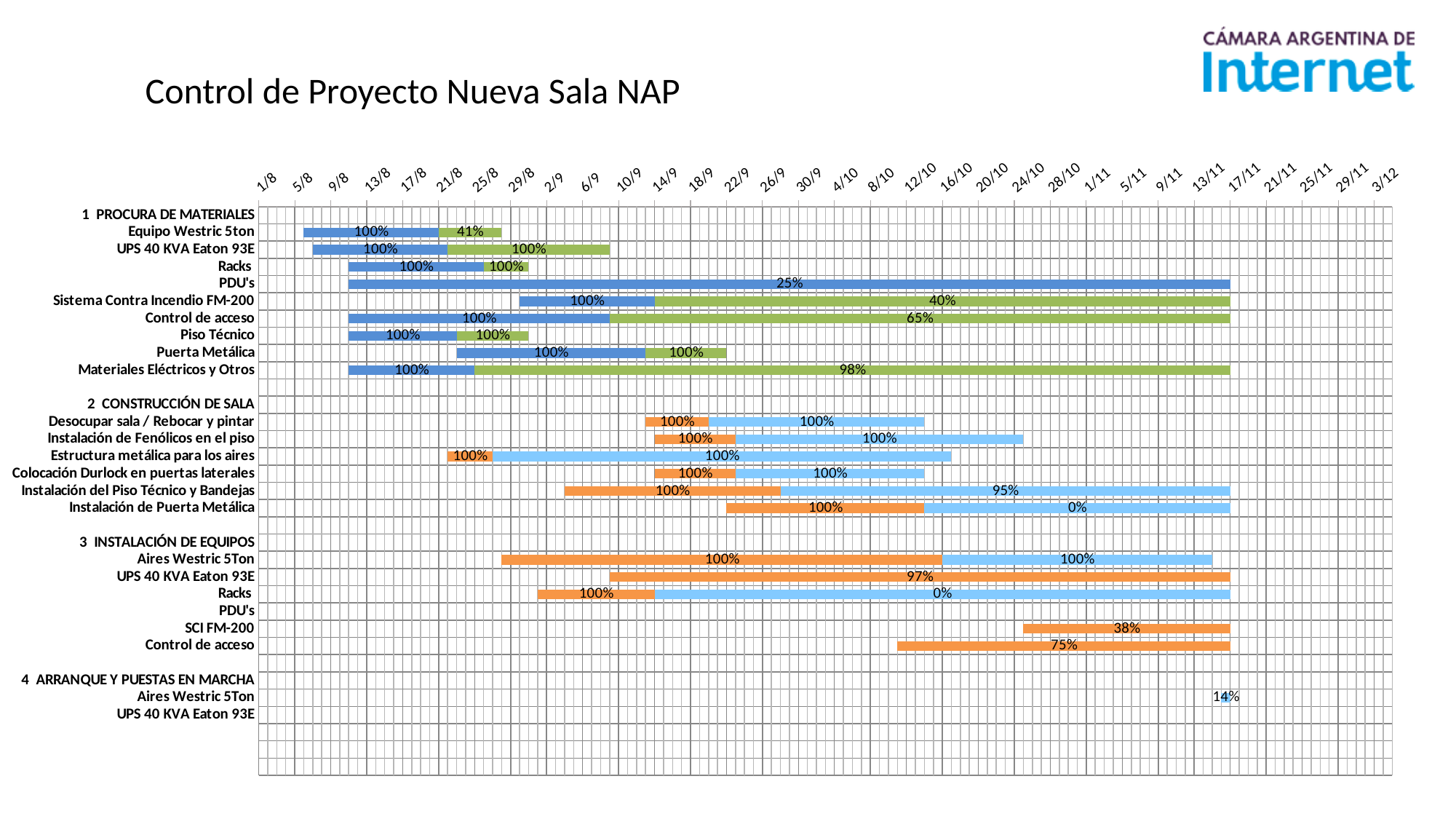
Which has a higher printed percentage in section 1: the green bar for Control de acceso or the green bar for Sistema Contra Incendio FM-200? Control de acceso What percentage is printed on the SCI FM-200 bar in section 3 Instalación de Equipos? 38% What is the title of the slide? Control de Proyecto Nueva Sala NAP What percentage is printed on the Control de acceso bar in section 3 Instalación de Equipos? 75% What percentage is shown on the green bar for Equipo Westric 5ton in section 1 Procura de Materiales? 41% What is the difference between the percentage on the Control de acceso bar (75%) and the SCI FM-200 bar (38%) in section 3 Instalación de Equipos? 37% What percentage is shown on the green bar for Sistema Contra Incendio FM-200? 40% What percentage is printed on the PDU's bar in section 1 Procura de Materiales? 25% What percentage is shown for Aires Westric 5Ton in section 4 Arranque y Puestas en Marcha? 14% What percentage is shown on the green bar for Control de acceso in section 1 Procura de Materiales? 65% How many numbered sections (phases) are listed on the chart? 4 What percentage is shown on the green bar for Materiales Eléctricos y Otros? 98%